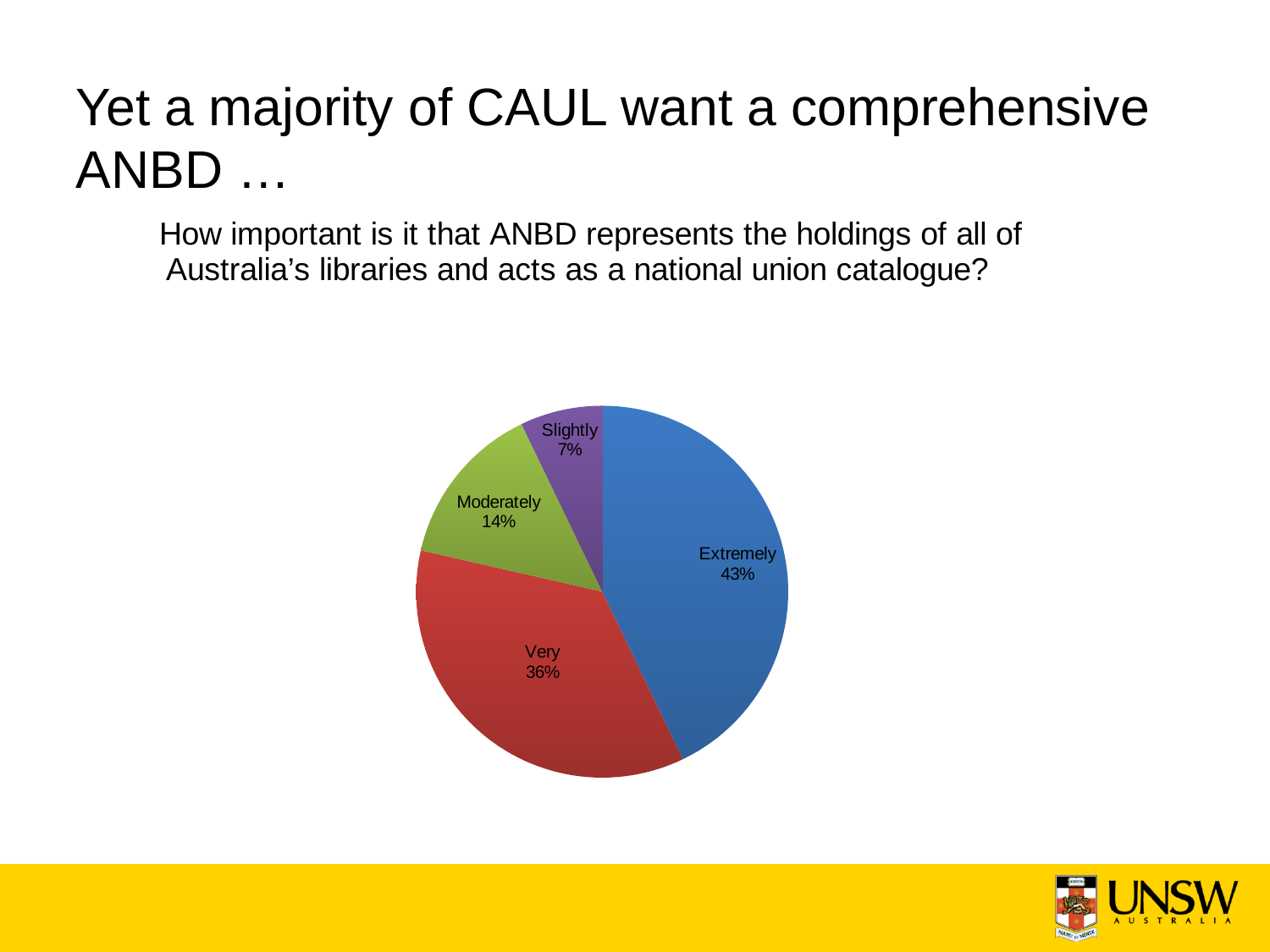
What kind of chart is shown on the slide? pie chart What percentage is shown for the Moderately slice? 14% How many slices does the pie chart have? 4 Which slice is larger, Moderately or Slightly? Moderately What percentage is shown for the Slightly slice? 7% What is the difference in percentage points between the Extremely and Very slices? 7 What colour is the Very slice of the pie chart? red Which response category has the largest slice of the pie? Extremely What share of the pie is labelled Very? 36% Which response category has the smallest slice of the pie? Slightly What percentage of respondents said it is extremely important that ANBD represents the holdings of all of Australia's libraries? 43% What is the combined percentage of the Extremely and Very slices? 79%